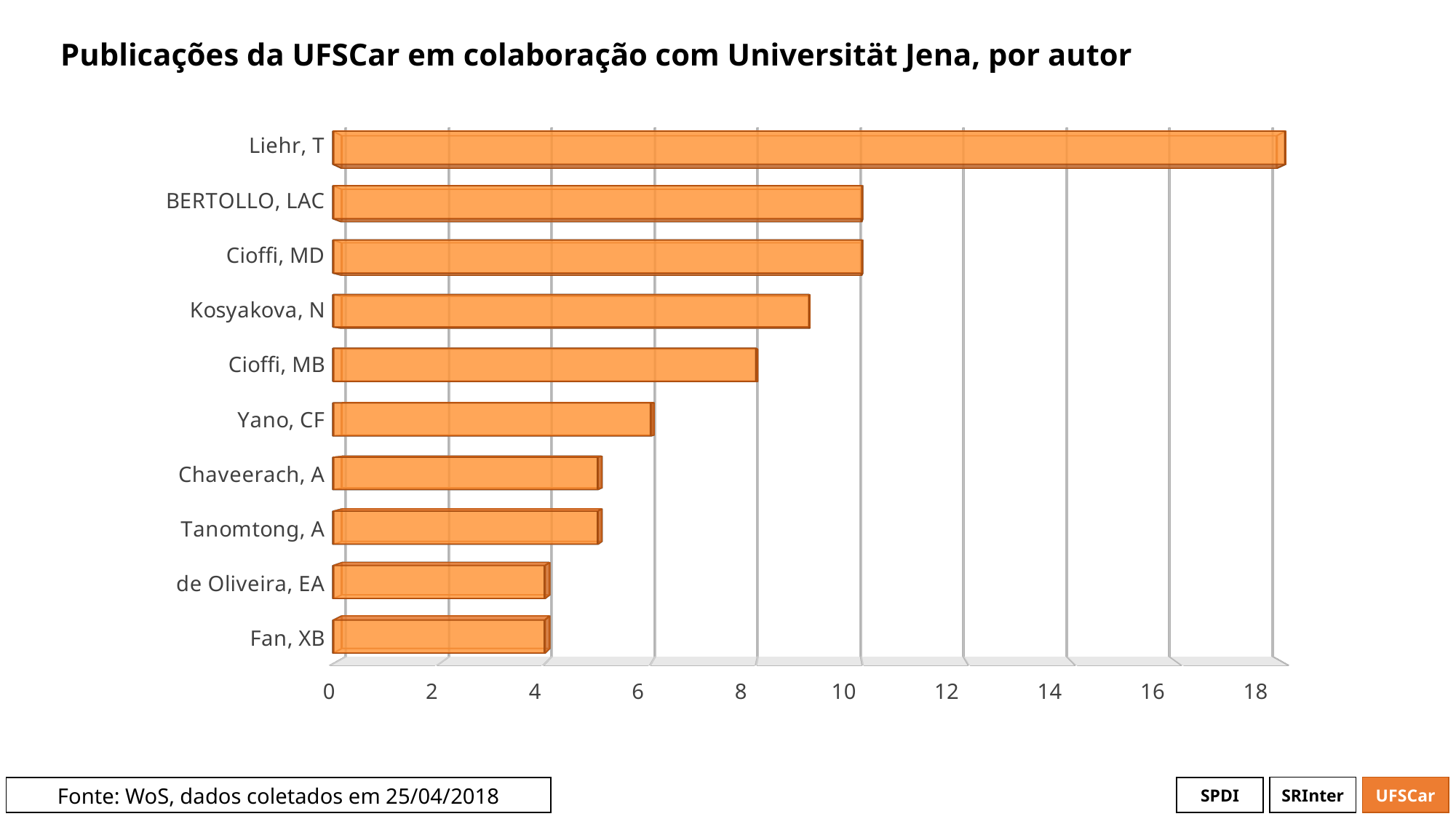
Who has more publications, Kosyakova, N or Cioffi, MB? Kosyakova, N Is the value for Kosyakova, N greater or less than 8? greater How many publications does Yano, CF have? 6 What kind of chart is shown on the slide? bar chart Which author has the highest number of publications? Liehr, T What is the difference in publications between Liehr, T and Yano, CF? 12 How many publications does Cioffi, MB have? 8 How many publications does BERTOLLO, LAC have? 10 How many publications does Liehr, T have? 18 How many authors are listed in the chart? 10 Is the value for Chaveerach, A greater or less than 6? less What is the title of the chart? Publicações da UFSCar em colaboração com Universität Jena, por autor